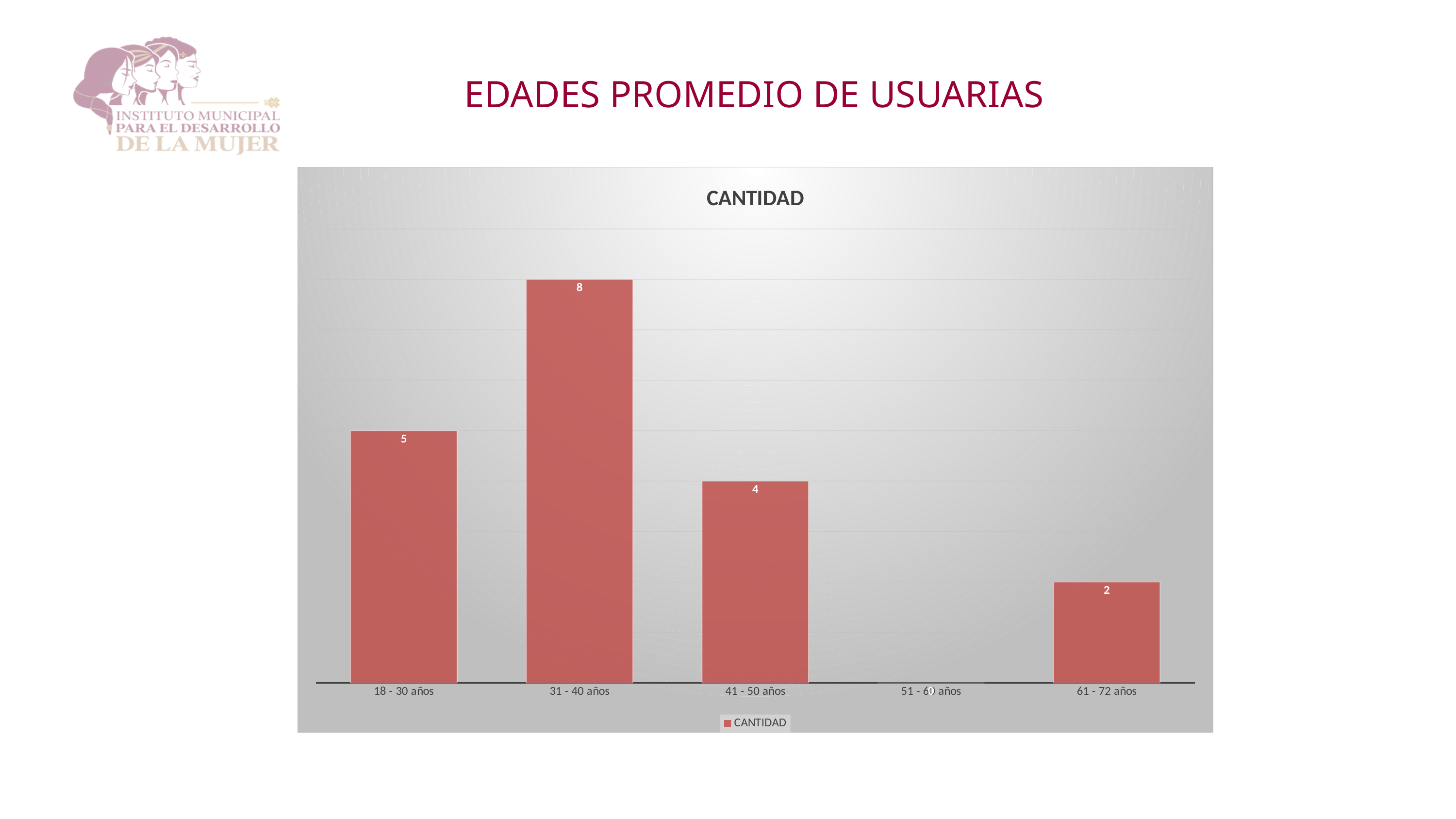
What is the title of the chart? CANTIDAD What is the value for 41 - 50 años? 4 How many series does the legend list? 1 What kind of chart is shown on the slide? Bar chart How many age categories are shown on the x axis? 5 What is the value for 31 - 40 años? 8 What is the difference between the values for 31 - 40 años and 18 - 30 años? 3 What is the value for 18 - 30 años? 5 Which is larger, the value for 41 - 50 años or the value for 61 - 72 años? 41 - 50 años What is the value for 61 - 72 años? 2 Which age group has the lowest value? 51 - 60 años Which age group has the highest value? 31 - 40 años